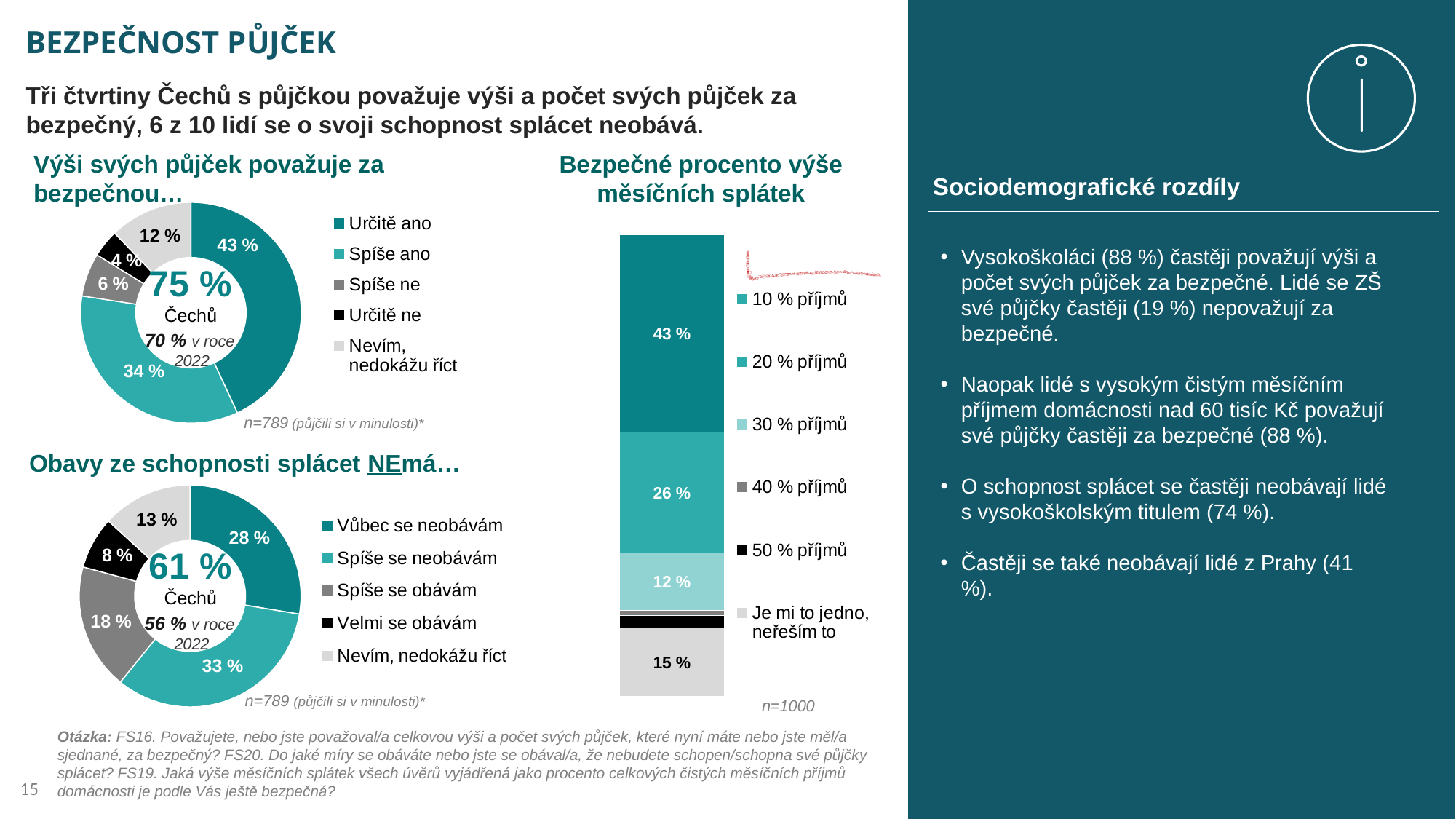
In the chart "Bezpečné procento výše měsíčních splátek", what is the difference between the shares for "20 % příjmů" and "30 % příjmů"? 14 % In the chart "Výši svých půjček považuje za bezpečnou…", how many entries does the legend list? 5 In the chart "Obavy ze schopnosti splácet NEmá…", what share of respondents answered "Spíše se neobávám"? 33 % In the chart "Výši svých půjček považuje za bezpečnou…", what share of respondents answered "Určitě ano"? 43 % In the chart "Bezpečné procento výše měsíčních splátek", what share of respondents chose "10 % příjmů"? 43 % What kind of chart is "Obavy ze schopnosti splácet NEmá…"? Donut chart In the chart "Bezpečné procento výše měsíčních splátek", what share of respondents chose "Je mi to jedno, neřeším to"? 15 % In the chart "Výši svých půjček považuje za bezpečnou…", what is the difference between the shares for "Určitě ano" and "Spíše ano"? 9 % What kind of chart is "Bezpečné procento výše měsíčních splátek"? Stacked bar chart In the chart "Obavy ze schopnosti splácet NEmá…", which is larger: "Spíše se obávám" or "Velmi se obávám"? Spíše se obávám In the chart "Výši svých půjček považuje za bezpečnou…", which answer has the smallest share? Určitě ne In the chart "Obavy ze schopnosti splácet NEmá…", which answer has the largest share? Spíše se neobávám